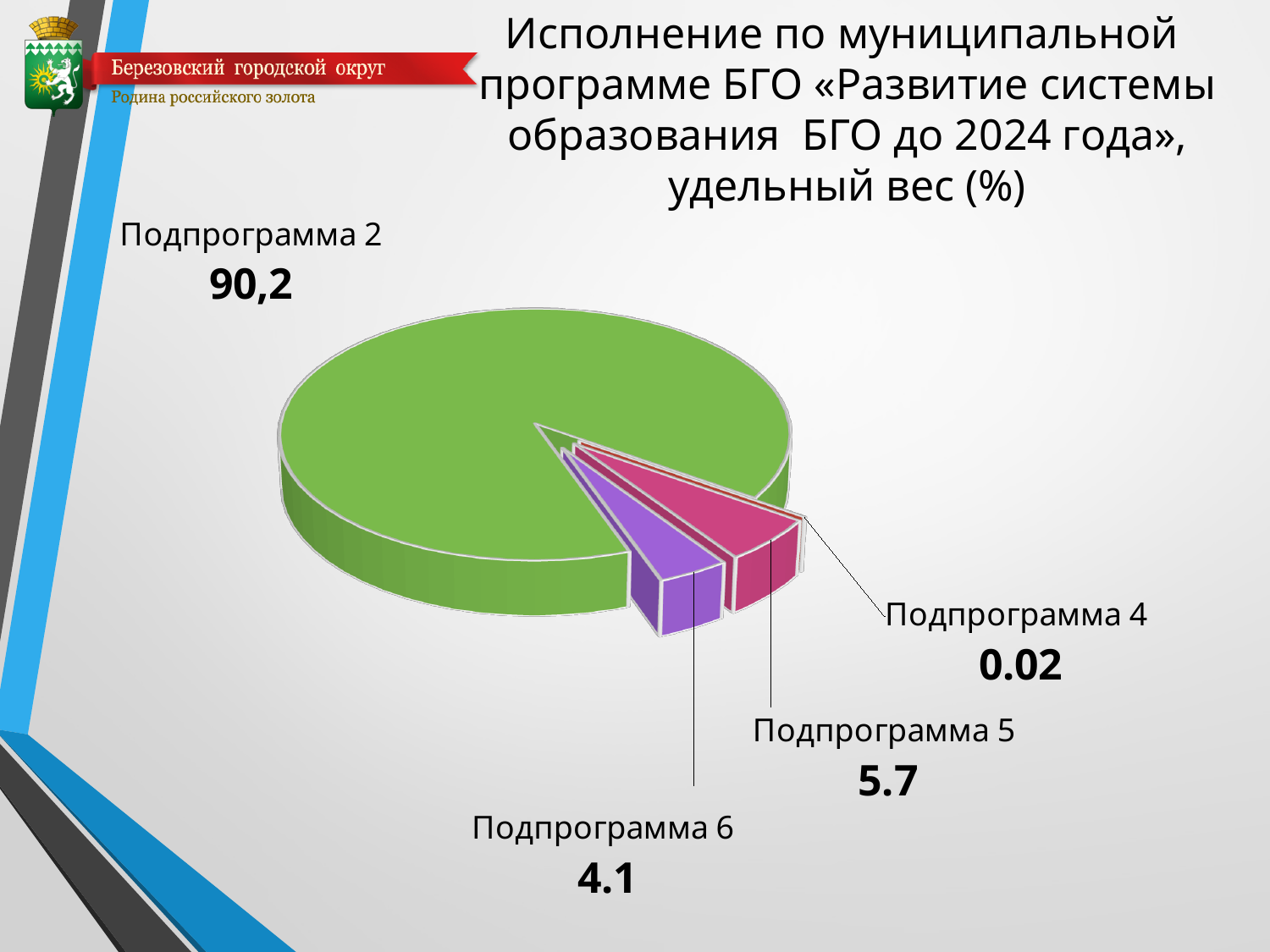
What is the value shown for Подпрограмма 6? 4.1 Which is larger, the value for Подпрограмма 5 or for Подпрограмма 6? Подпрограмма 5 What is the value shown for Подпрограмма 2? 90,2 What is the difference between the values for Подпрограмма 6 and Подпрограмма 4? 4.08 Which category has the largest share of the pie? Подпрограмма 2 Which category has the smallest share of the pie? Подпрограмма 4 What is the value shown for Подпрограмма 4? 0.02 What colour is the slice for Подпрограмма 2? green What type of chart is shown on the slide? pie chart How many slices (categories) does the pie chart have? 4 What is the value shown for Подпрограмма 5? 5.7 What is the difference between the values for Подпрограмма 5 and Подпрограмма 6? 1.6